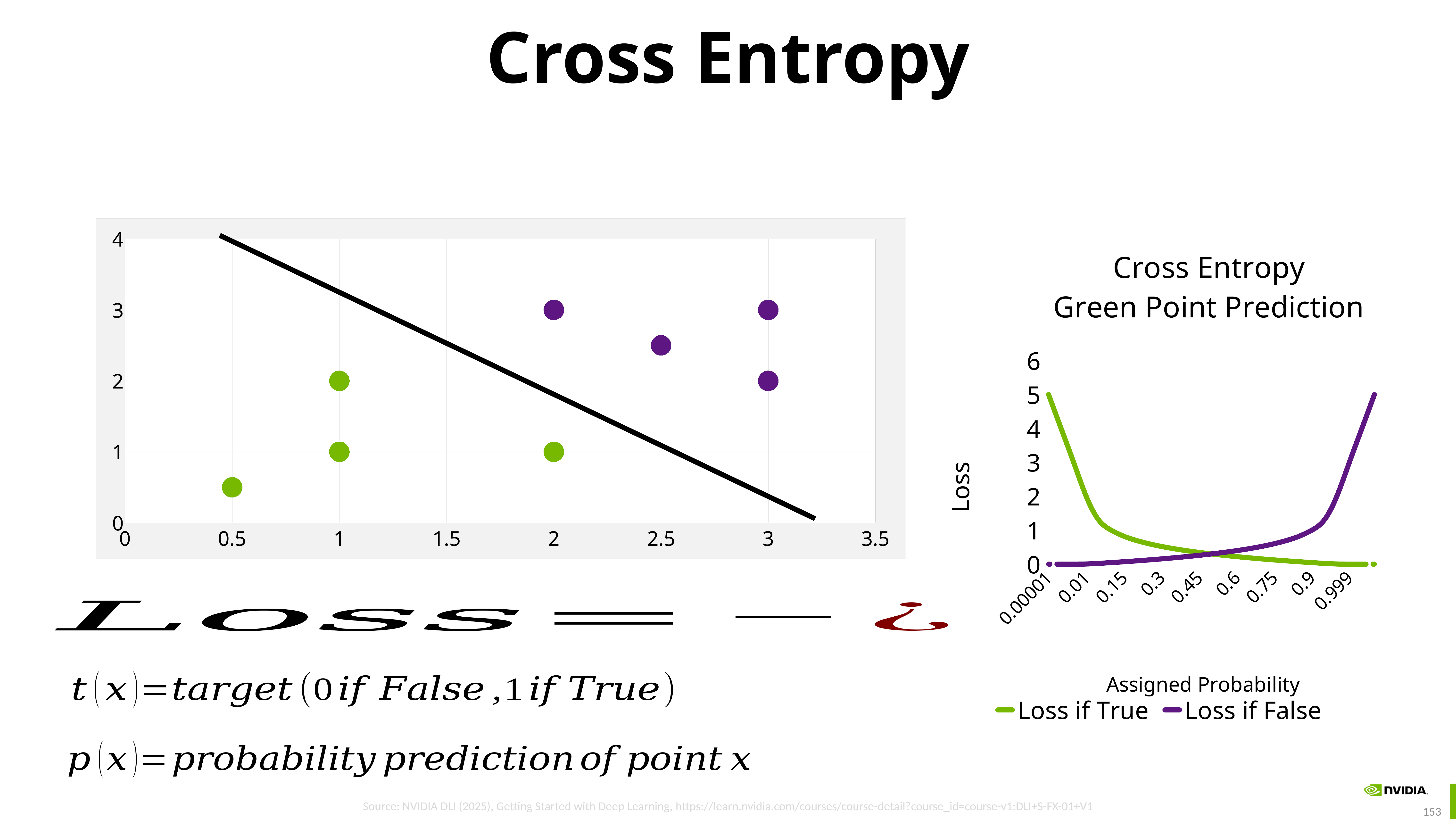
In the chart titled "Cross Entropy Green Point Prediction", what is the label of the y axis? Loss In the chart titled "Cross Entropy Green Point Prediction", does the Loss if False series rise or fall as Assigned Probability increases? rise In the chart titled "Cross Entropy Green Point Prediction", is the Loss if False value at 0.01 greater or less than 1? less In the scatter chart on the left, how many points are plotted in total? 8 In the scatter chart on the left, how many green points are plotted? 4 In the chart titled "Cross Entropy Green Point Prediction", how many series does the legend list? 2 What kind of chart is the chart titled "Cross Entropy Green Point Prediction"? line chart In the chart titled "Cross Entropy Green Point Prediction", is the Loss if True value at 0.00001 greater or less than 4? greater In the chart titled "Cross Entropy Green Point Prediction", how many categories are shown on the x axis? 9 What kind of chart is the chart on the left of the slide? scatter chart In the chart titled "Cross Entropy Green Point Prediction", which series has the larger value at 0.9, Loss if True or Loss if False? Loss if False In the chart titled "Cross Entropy Green Point Prediction", does the Loss if True series rise or fall as Assigned Probability increases? fall